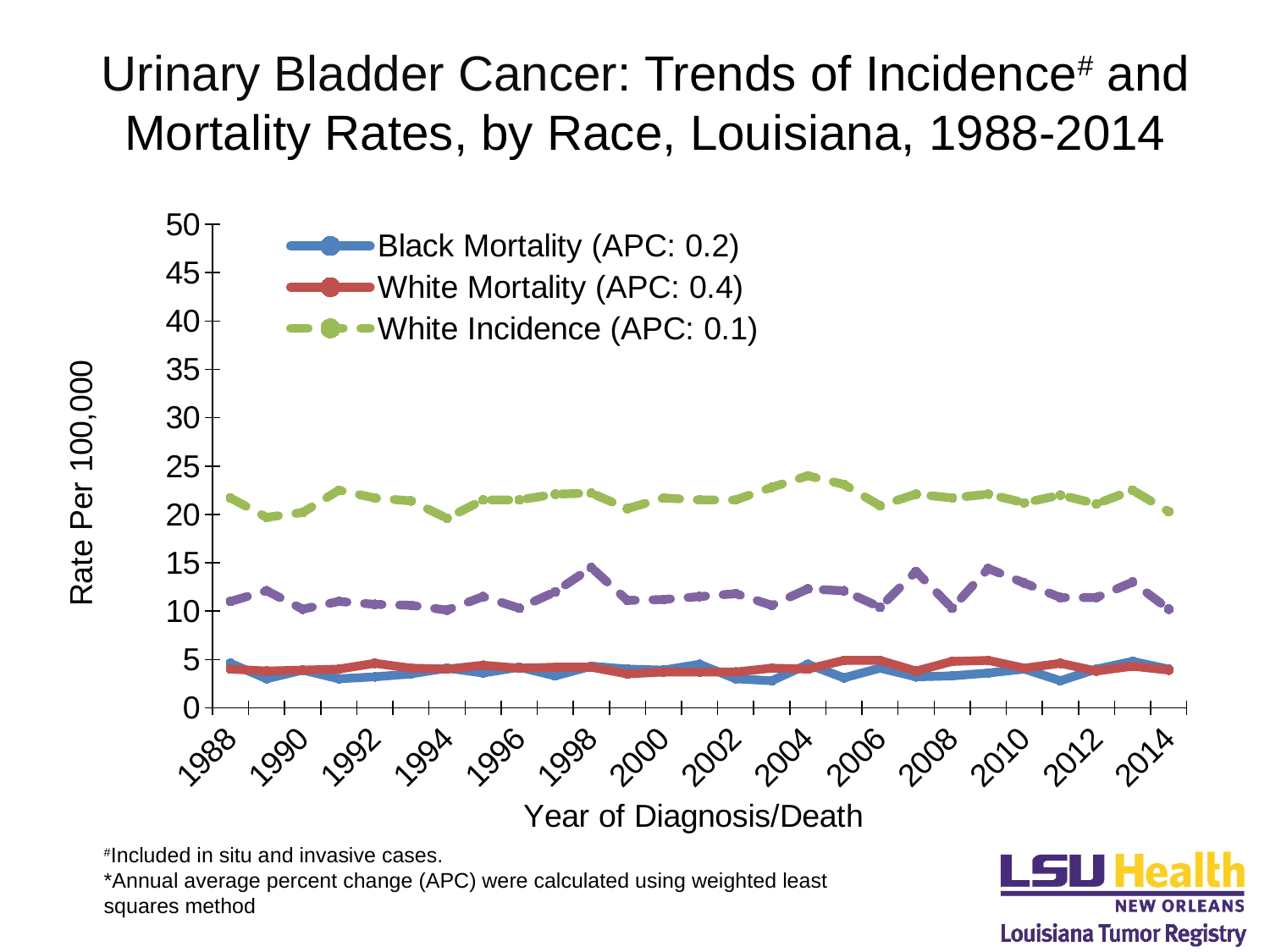
Is the value for White Incidence in 1994 greater or less than 25? less What type of chart is shown on the slide? Line chart Is the value for White Incidence in 2004 greater or less than 20? greater Which series in the legend has the highest values across the years? White Incidence (APC: 0.1) What is the first year and the last year shown on the x axis? 1988 and 2014 In 2010, which is larger: White Incidence or White Mortality? White Incidence Does the White Incidence line show a strong rise, a strong fall, or stay roughly flat from 1988 to 2014? Roughly flat How many series does the legend list? 3 What APC value is given for Black Mortality in the legend? 0.2 Is the value for White Mortality in 2000 greater or less than 5? less What is the title of the y axis? Rate Per 100,000